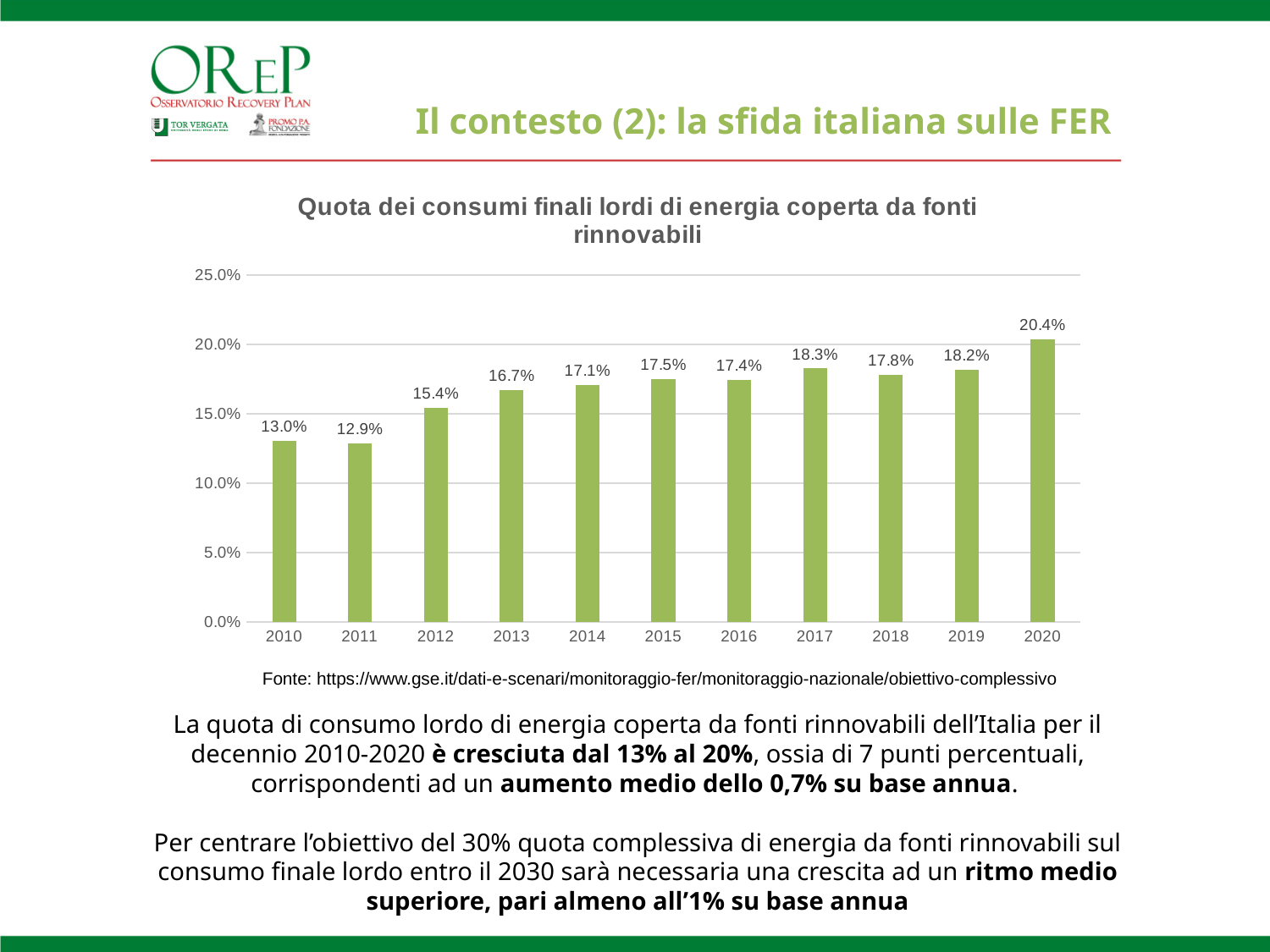
Which is larger, the value for 2017 or the value for 2018? 2017 What kind of chart is shown? bar chart What is the value for 2016? 17.4% What is the title of the chart? Quota dei consumi finali lordi di energia coperta da fonti rinnovabili What is the value for 2010? 13.0% Do the values generally rise or fall from 2010 to 2020? rise How many years are shown on the x axis? 11 What is the difference between the values for 2020 and 2010? 7.4% Is the value for 2012 greater or less than 15.0%? greater Which year has the highest value? 2020 What is the value for 2019? 18.2% Which year has the lowest value? 2011